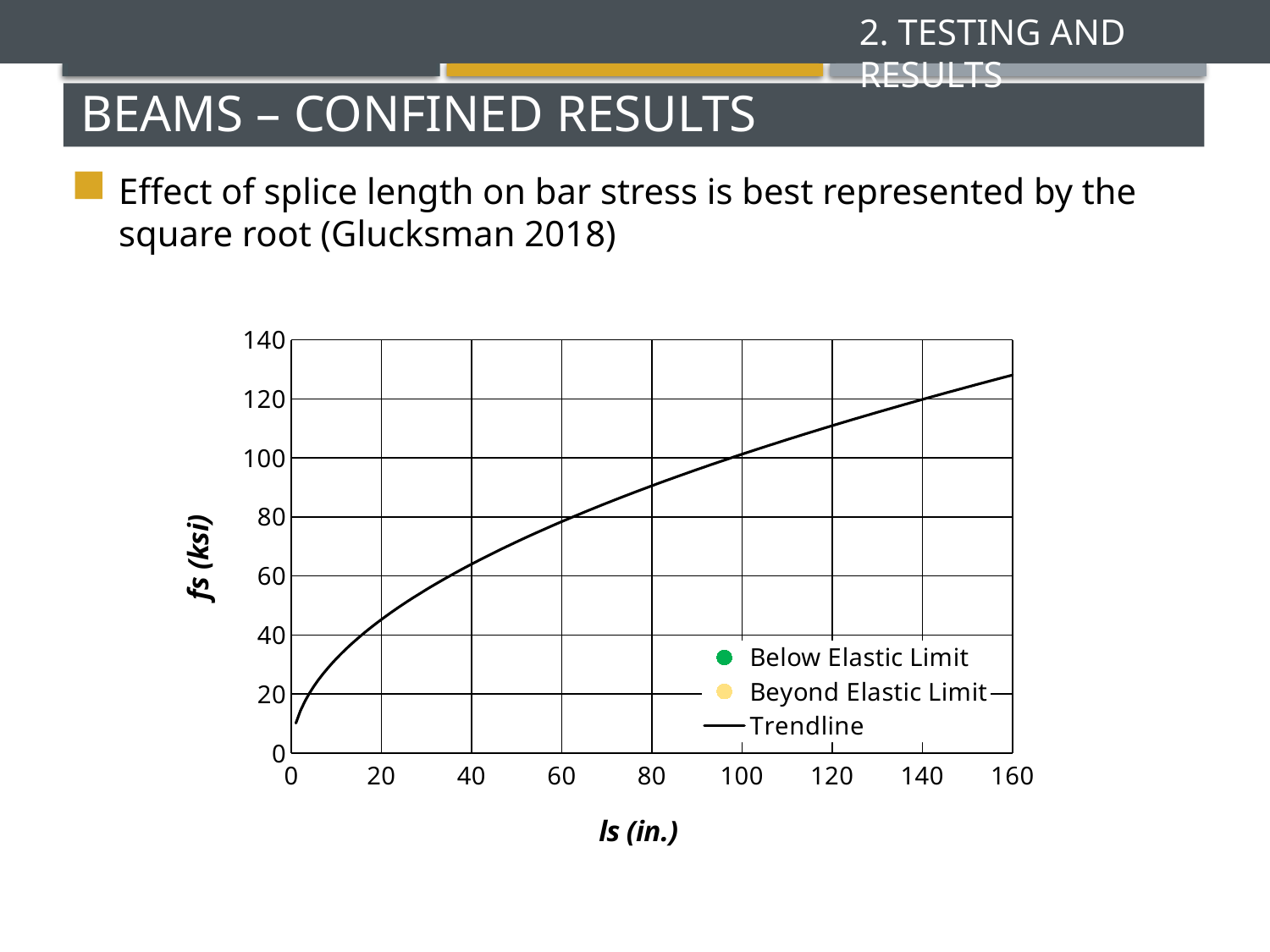
Is the trendline value of fs at ls = 80 in. greater or less than 100? less What is the label of the chart's y axis? fs (ksi) Is the trendline value of fs at ls = 160 in. greater or less than 120? greater Is the trendline value of fs at ls = 120 in. greater or less than 100? greater Does the trendline rise or fall as ls increases along the x axis? rises What kind of chart is shown on the slide? line chart What is the label of the chart's x axis? ls (in.) How many series does the chart's legend list? 3